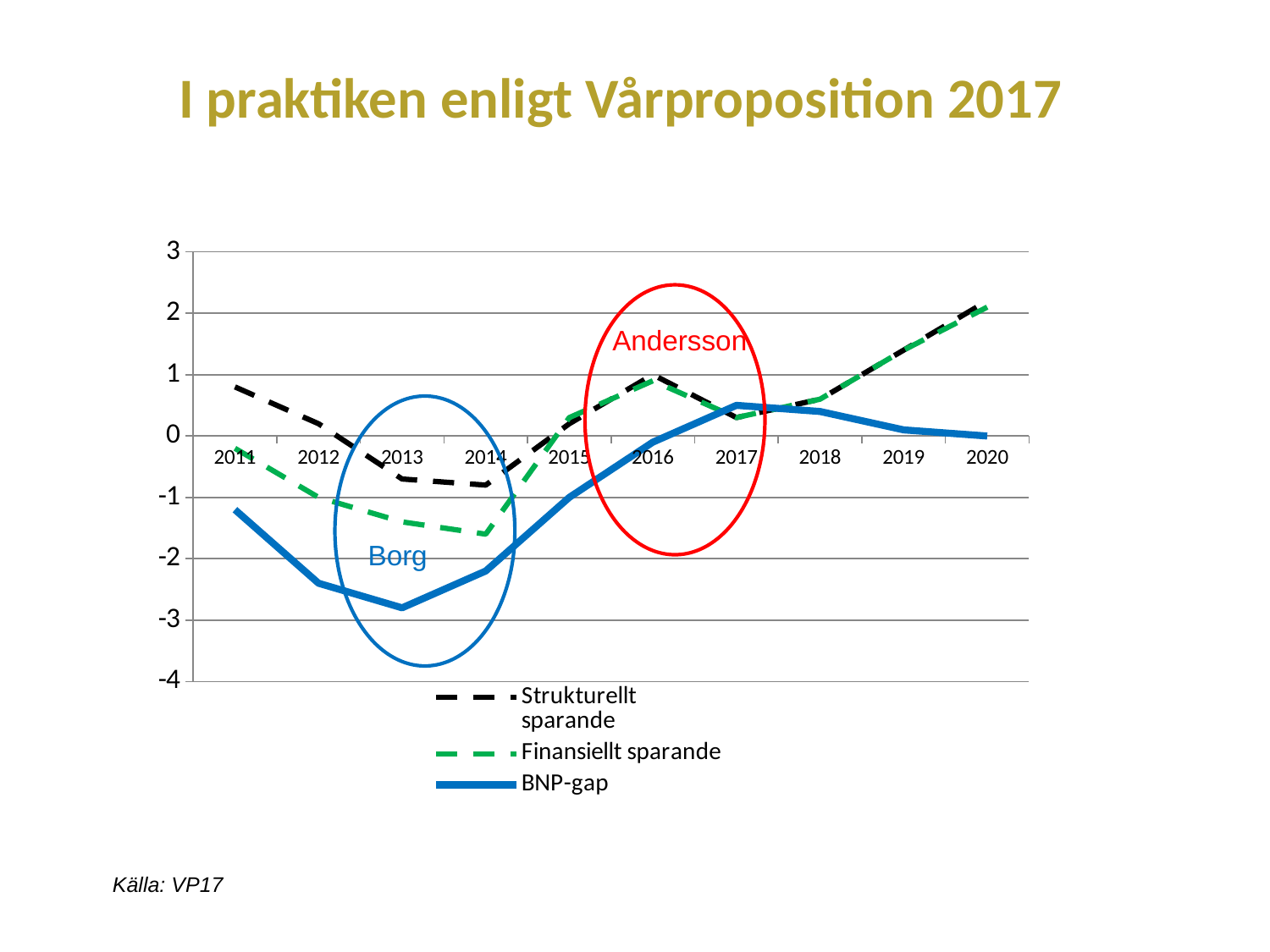
In which year is the BNP-gap at its lowest? 2013 What name is written inside the red circle on the chart? Andersson What kind of chart is shown on the slide? line chart Is the value for Strukturellt sparande in 2020 greater or less than 1? greater How many years are shown on the x axis? 10 In which year is Strukturellt sparande at its highest? 2020 Which series is drawn as a solid blue line? BNP-gap In 2011, which is higher: Strukturellt sparande or Finansiellt sparande? Strukturellt sparande Is the value for BNP-gap in 2013 greater or less than -2? less Is the value for Finansiellt sparande in 2014 greater or less than -1? less Does the BNP-gap rise or fall from 2013 to 2017? rise How many series does the legend list? 3